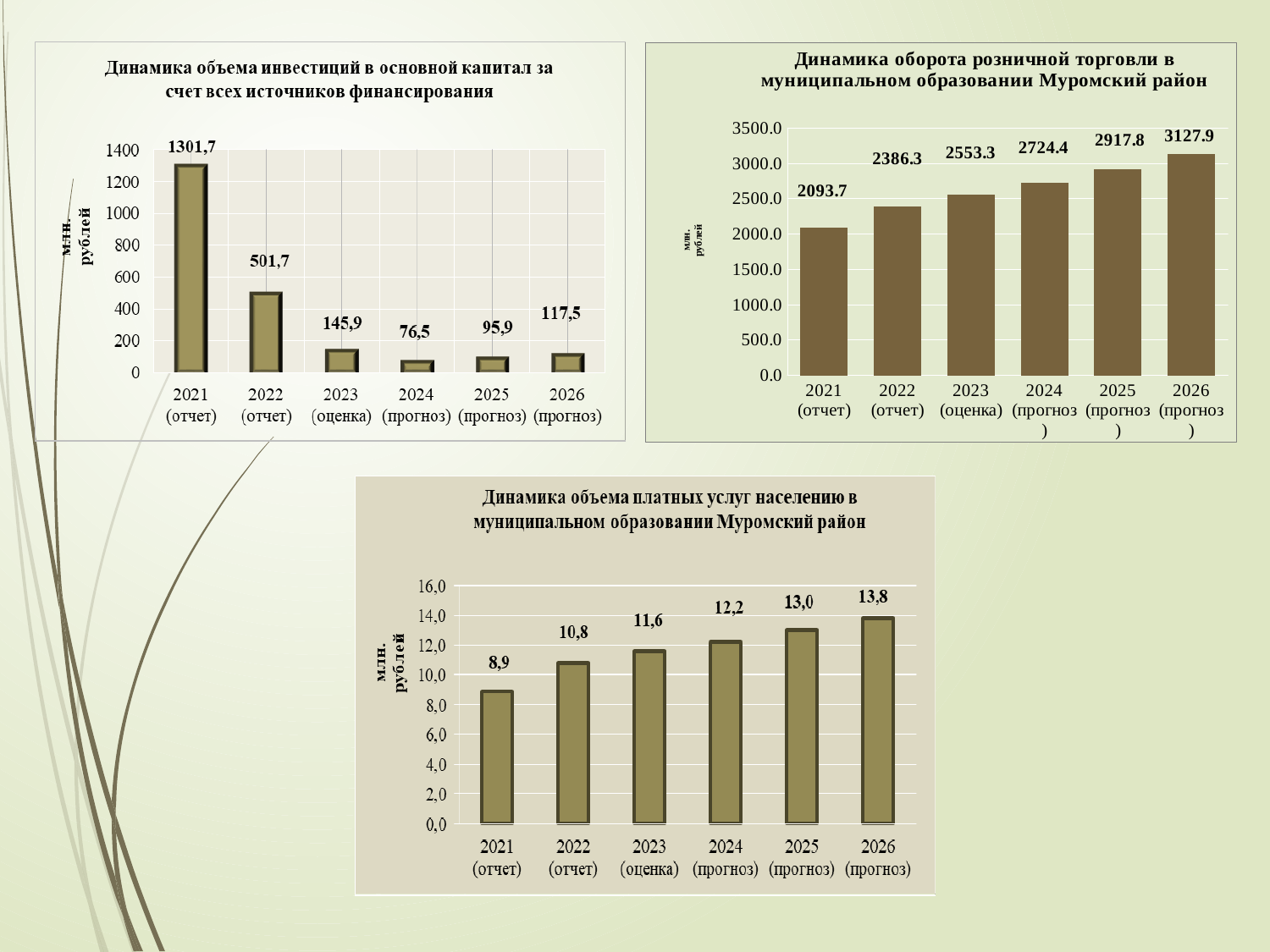
In the top-left chart (Динамика объема инвестиций в основной капитал), what is the difference between the 2021 and 2022 values? 800,0 In the top-left chart (Динамика объема инвестиций в основной капитал), how many bars are plotted? 6 In the bottom chart (Динамика объема платных услуг населению), what is the difference between the 2026 and 2021 values? 4,9 In the top-right chart (Динамика оборота розничной торговли), which year has the highest value? 2026 (прогноз) What type of chart is the bottom chart (Динамика объема платных услуг населению)? bar chart In the top-left chart (Динамика объема инвестиций в основной капитал), what is the value for 2021 (отчет)? 1301,7 In the top-right chart (Динамика оборота розничной торговли), what is the value for 2024 (прогноз)? 2724.4 In the top-left chart (Динамика объема инвестиций в основной капитал), which year has the lowest value? 2024 (прогноз) In the bottom chart (Динамика объема платных услуг населению), what is the value for 2023 (оценка)? 11,6 In the bottom chart (Динамика объема платных услуг населению), which is larger: the value for 2022 or the value for 2025? 2025 In the top-right chart (Динамика оборота розничной торговли), what is the difference between the 2026 and 2021 values? 1034.2 In the top-right chart (Динамика оборота розничной торговли), do the values rise or fall from 2021 to 2026? rise